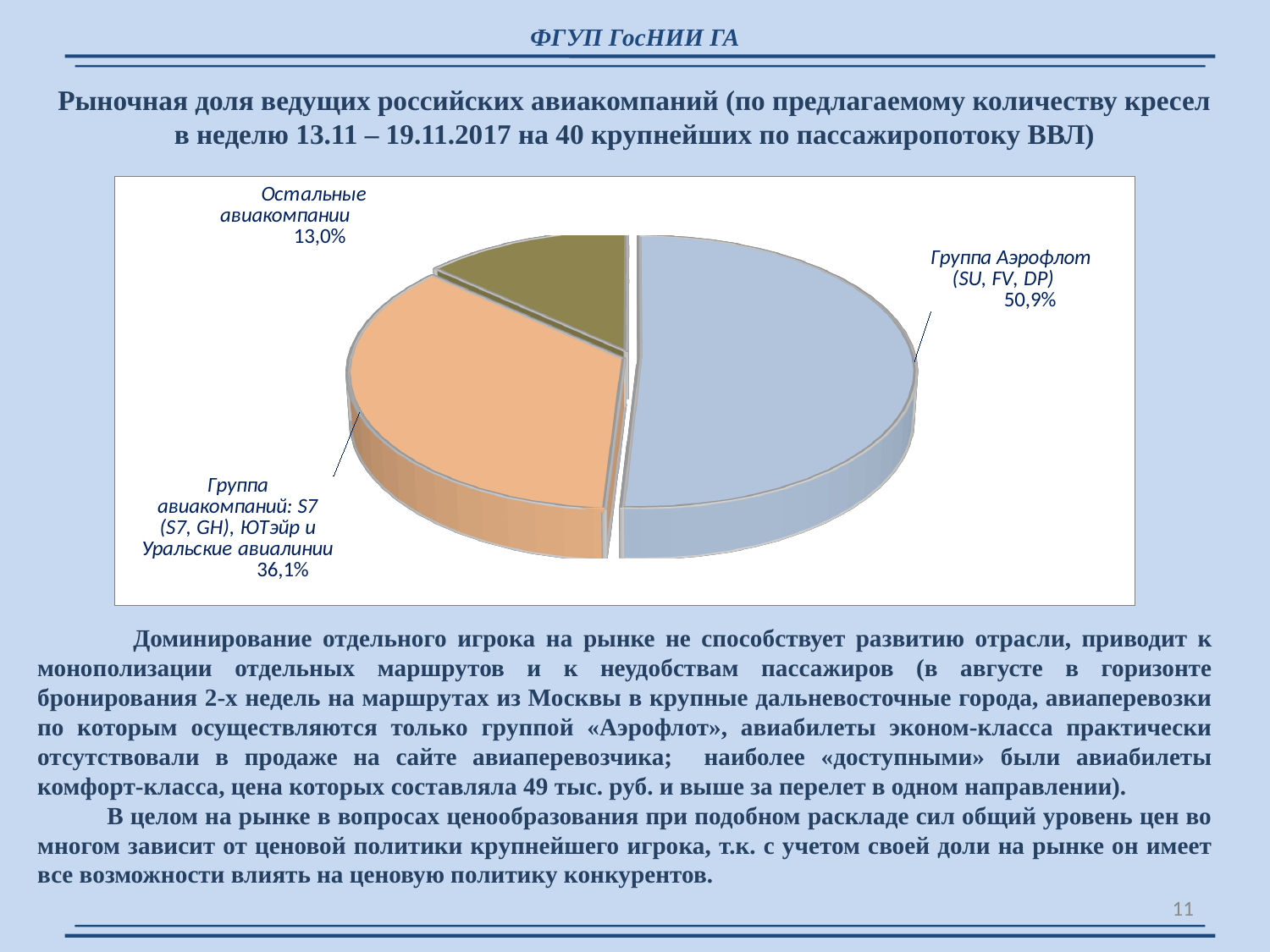
What share of the pie does Группа Аэрофлот (SU, FV, DP) hold? 50,9% Which slice of the pie chart is the smallest? Остальные авиакомпании What week does the chart title say the seat-count data covers? 13.11 – 19.11.2017 What is the difference in share between the S7/ЮТэйр/Уральские авиалинии group and Остальные авиакомпании? 23,1% What share of the pie does Остальные авиакомпании hold? 13,0% What is the difference in share between Группа Аэрофлот (SU, FV, DP) and the S7/ЮТэйр/Уральские авиалинии group? 14,8% What share of the pie does the group S7 (S7, GH), ЮТэйр и Уральские авиалинии hold? 36,1% Which slice of the pie chart is the largest? Группа Аэрофлот (SU, FV, DP) How many slices does the pie chart have? 3 Which has a larger share: Остальные авиакомпании or Группа Аэрофлот (SU, FV, DP)? Группа Аэрофлот (SU, FV, DP) What kind of chart is shown on the slide? Pie chart Is the share of Группа Аэрофлот (SU, FV, DP) greater or less than 50%? greater